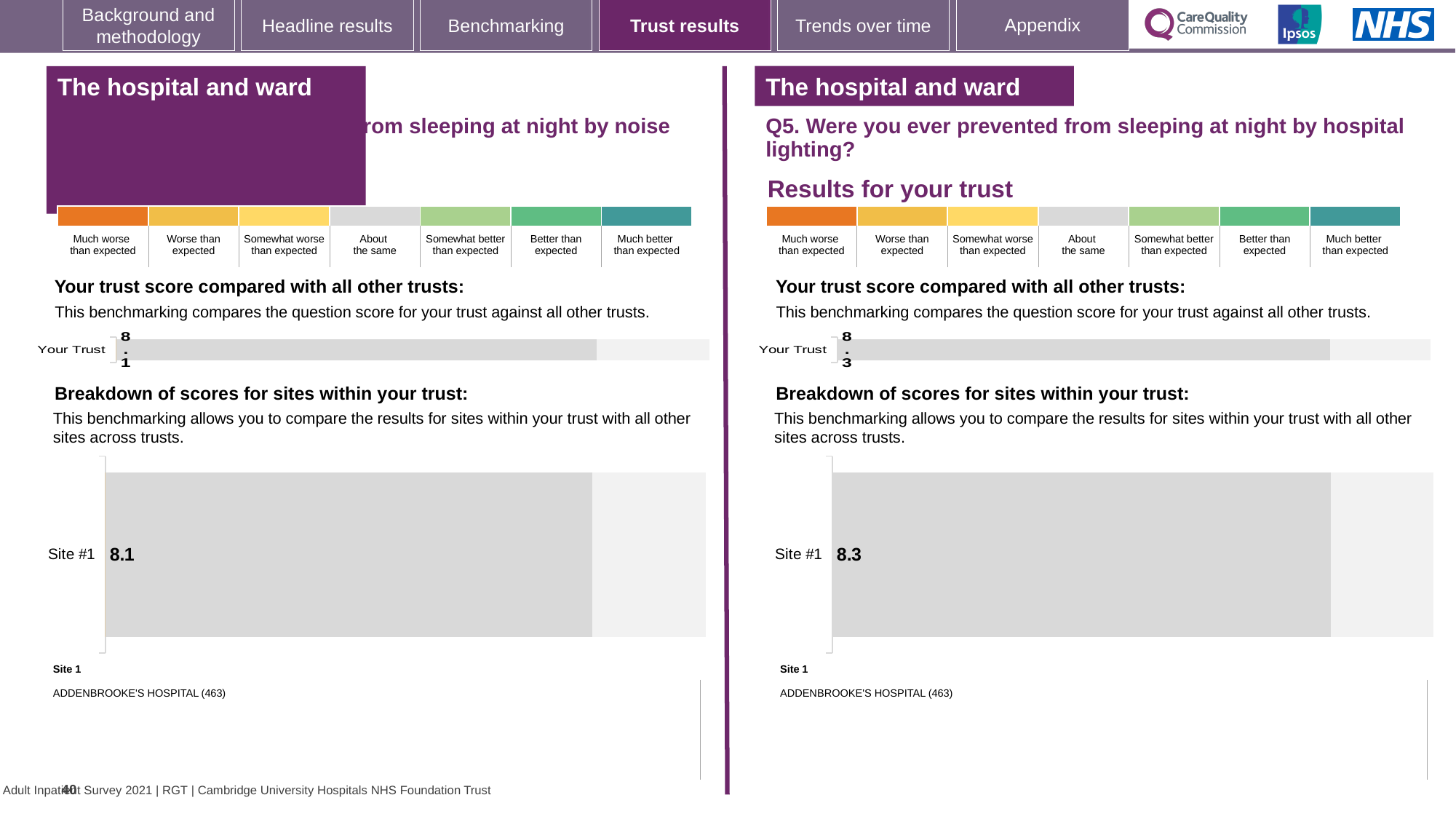
Which question is shown on the right-hand side of the slide? Q5. Were you ever prevented from sleeping at night by hospital lighting? On the right-hand side of the slide (Q5, hospital lighting), what is the score shown for Your Trust? 8.3 On the left-hand side of the slide, what is the score shown for Your Trust? 8.1 What is the difference between the Site #1 score on the right-hand side (8.3) and the Site #1 score on the left-hand side (8.1)? 0.2 Which is larger: the Your Trust score on the left-hand side of the slide or the Your Trust score on the right-hand side? Right-hand side (8.3) How many sites are shown in the right-hand 'Breakdown of scores for sites within your trust' chart? 1 In the right-hand 'Breakdown of scores for sites within your trust' chart, what is the score for Site #1? 8.3 In the left-hand 'Breakdown of scores for sites within your trust' chart, what is the score for Site #1? 8.1 Which hospital is listed as Site 1 on the right-hand side of the slide? ADDENBROOKE'S HOSPITAL (463) How many sites are shown in the left-hand 'Breakdown of scores for sites within your trust' chart? 1 What kind of chart is used to show the Site #1 score on the right-hand side of the slide? Bar chart